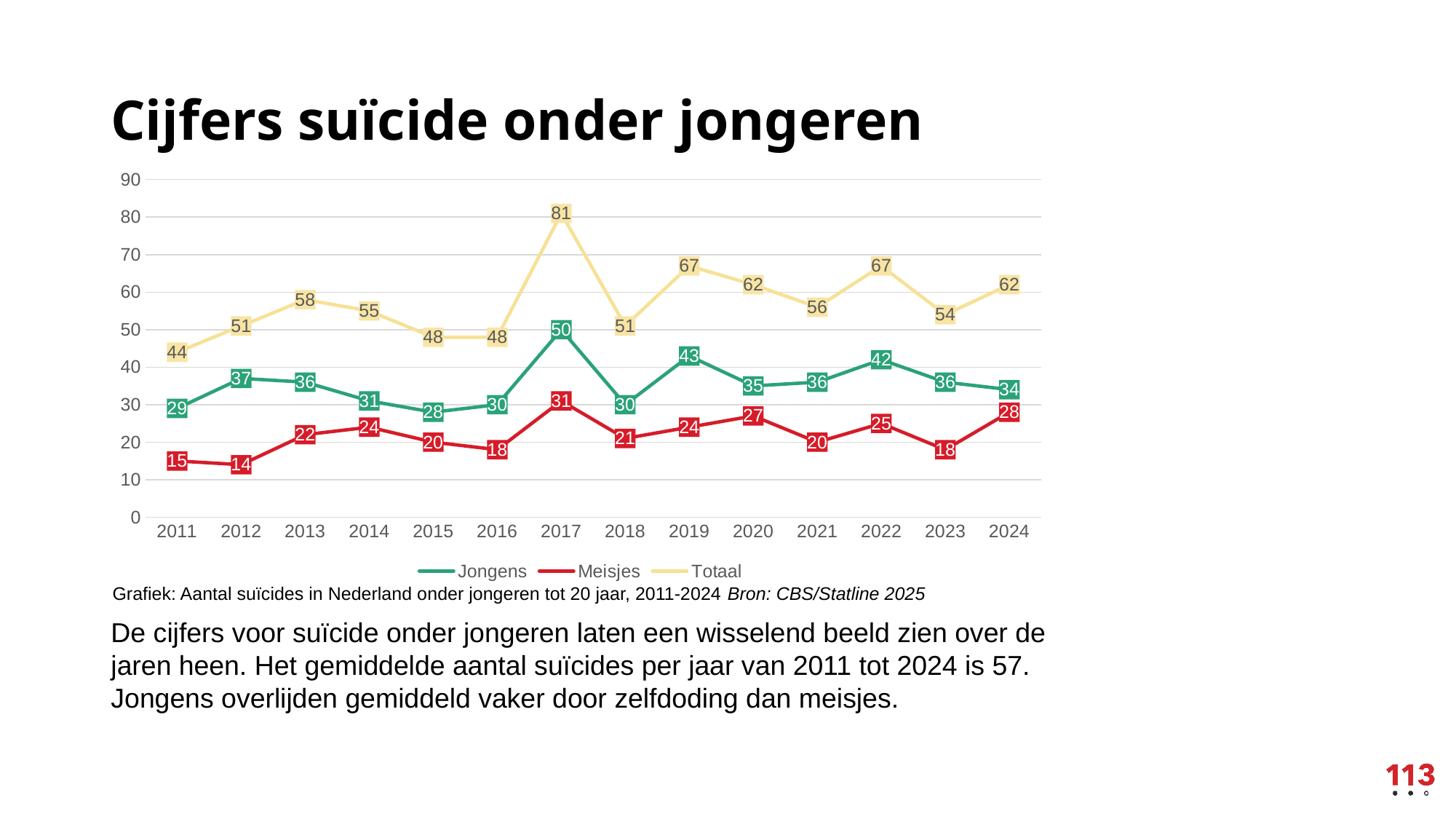
In which year is the Jongens series lowest? 2015 What is the difference between Jongens and Meisjes in 2024? 6 Which is larger, the Totaal value in 2013 or the Totaal value in 2014? 2013 Which series is shown in red in the legend? Meisjes What kind of chart is shown on the slide? line chart Is the value for Totaal in 2011 greater or less than 40? greater How many series does the legend list? 3 What is the value for Meisjes in 2012? 14 How many years are shown on the x axis? 14 In which year is the Totaal series highest? 2017 What is the value for Jongens in 2019? 43 What is the value for Totaal in 2017? 81